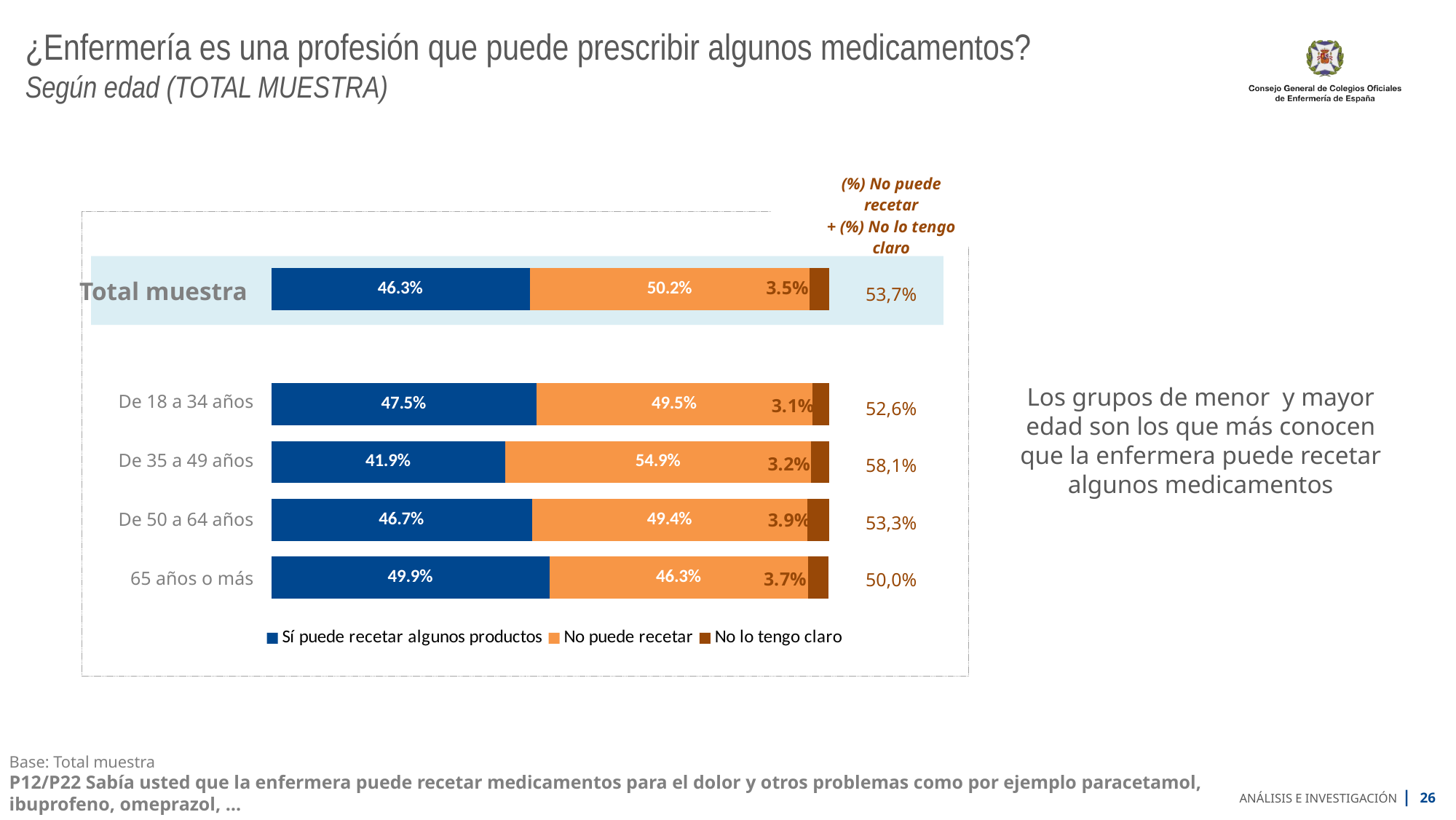
How many series does the legend list? 3 Which age group has the lowest 'Sí puede recetar algunos productos' percentage? De 35 a 49 años Which has a larger 'No puede recetar' value: 'De 35 a 49 años' or 'De 50 a 64 años'? De 35 a 49 años What percentage of the 'De 35 a 49 años' group answered 'Sí puede recetar algunos productos'? 41.9% What is the difference in the 'Sí puede recetar algunos productos' percentage between '65 años o más' and 'De 35 a 49 años'? 8.0 percentage points What is the total of the three segments in the 'Total muestra' bar? 100.0% What kind of chart is shown on the slide? Stacked bar chart What is the 'No puede recetar' value for the '65 años o más' group? 46.3% How many bars (rows) are shown in the chart, including 'Total muestra'? 5 What is the 'No lo tengo claro' value for the 'De 50 a 64 años' group? 3.9% Which age group has the highest 'Sí puede recetar algunos productos' percentage? 65 años o más What is the combined '(%) No puede recetar + (%) No lo tengo claro' figure shown for 'De 35 a 49 años'? 58,1%